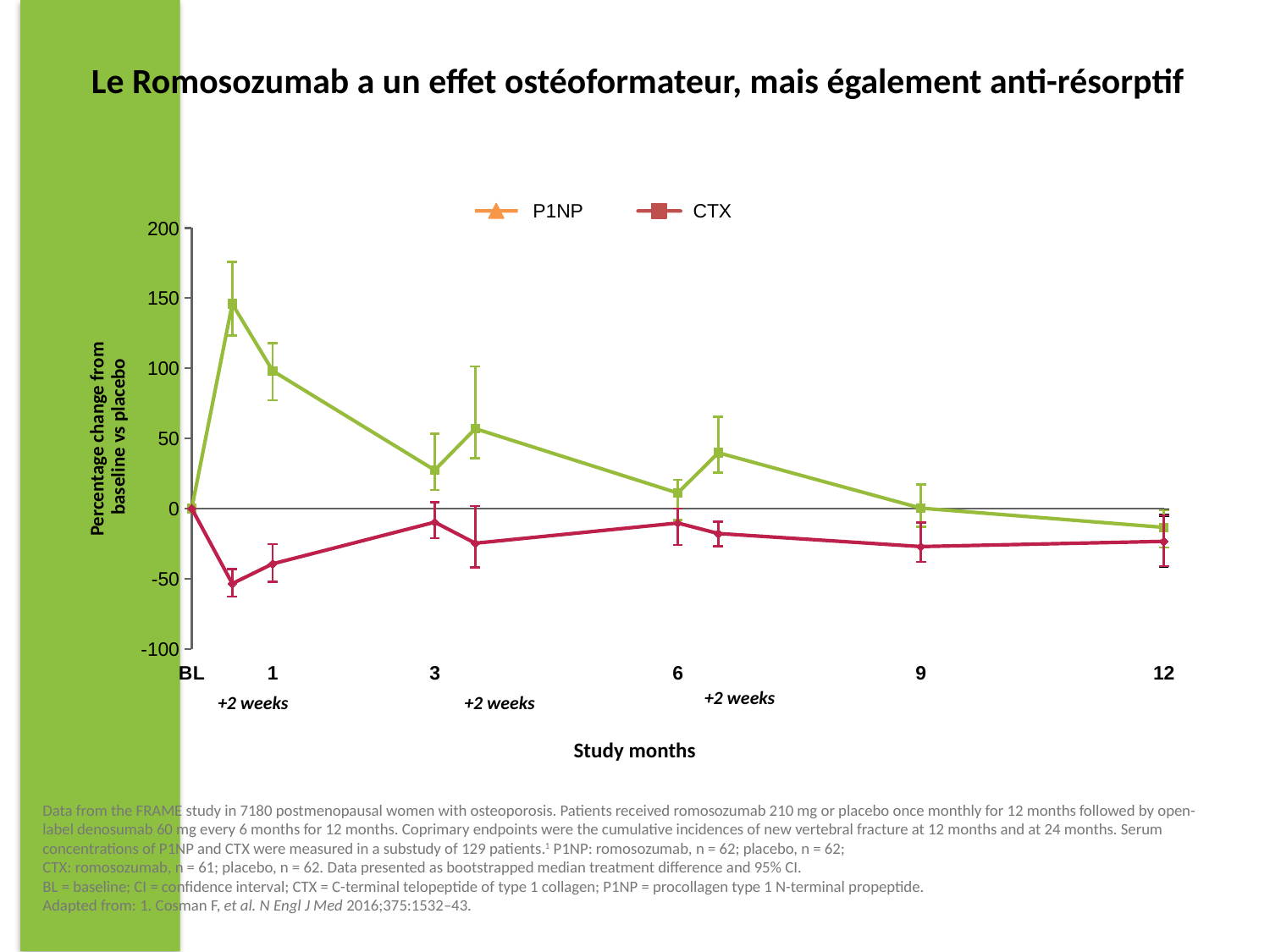
At month 1, which series has the higher value, P1NP or CTX? P1NP Which series reaches the highest value on the chart? P1NP What are the two series named in the legend? P1NP and CTX How many series does the legend list? 2 Is the value for P1NP at the first +2 weeks point (just after BL) greater or less than 100? greater What is the title of the vertical axis? Percentage change from baseline vs placebo Is the value for P1NP at month 1 greater or less than 50? greater What is the value of both series at BL (baseline)? 0 Which series reaches the lowest value on the chart? CTX Is the value for CTX at month 1 greater or less than 0? less What kind of chart is shown on the slide? line chart